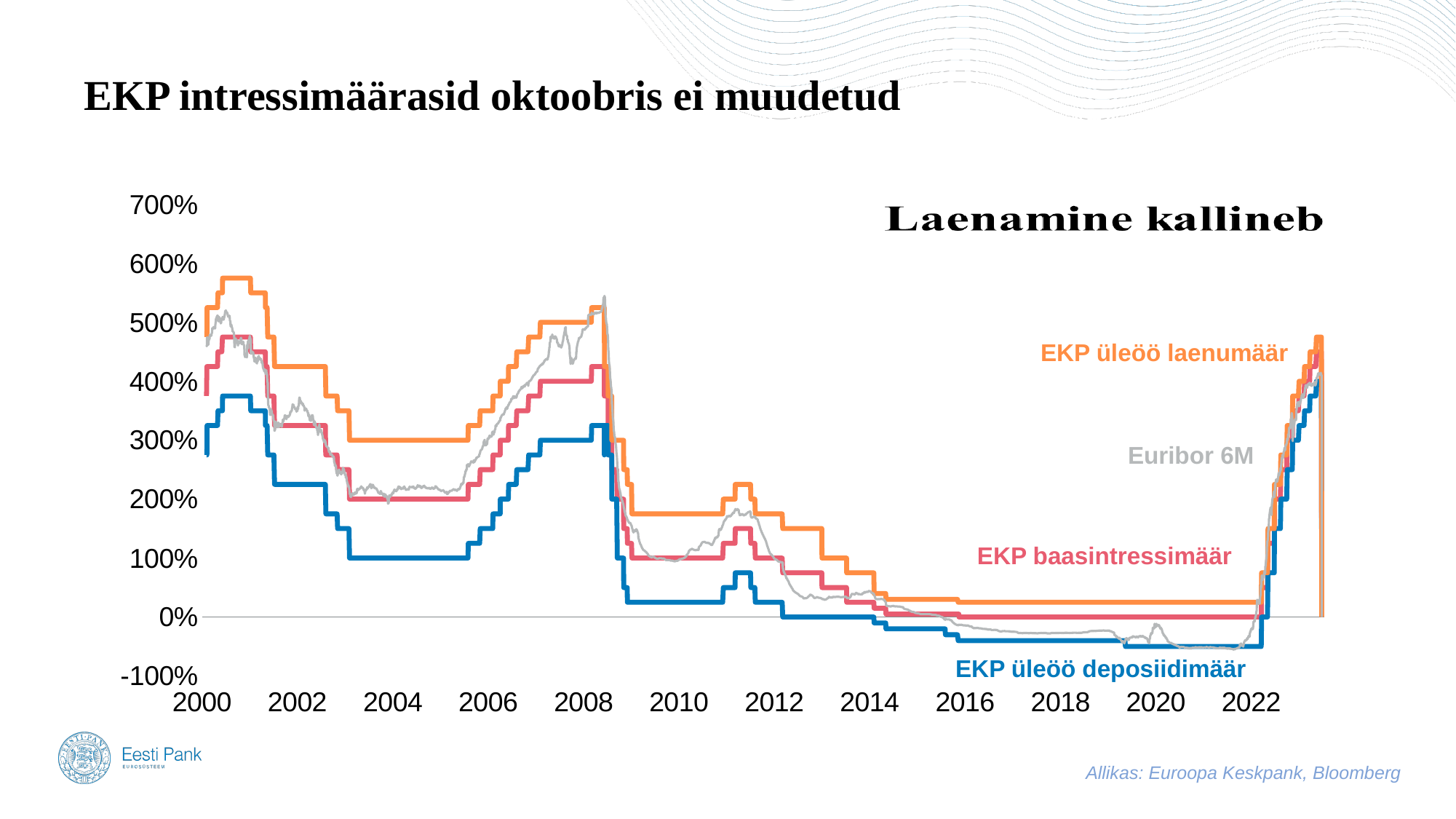
In 2001, which is higher: EKP üleöö laenumäär or EKP üleöö deposiidimäär? EKP üleöö laenumäär Is the value of EKP baasintressimäär in 2016 greater or less than 100%? less Is the value of Euribor 6M in 2021 greater or less than 0%? less What is the title of the slide? EKP intressimäärasid oktoobris ei muudetud Which series is the lowest line on the chart throughout the period? EKP üleöö deposiidimäär Did the interest rates rise or fall after 2022? rise How many series are plotted on the chart? 4 What colour is the Euribor 6M line? grey What kind of chart is shown on the slide? line chart Did the interest rates rise or fall between 2008 and 2009? fall Which series is the highest line on the chart throughout the period? EKP üleöö laenumäär Is the value of EKP üleöö laenumäär in 2001 greater or less than 500%? greater